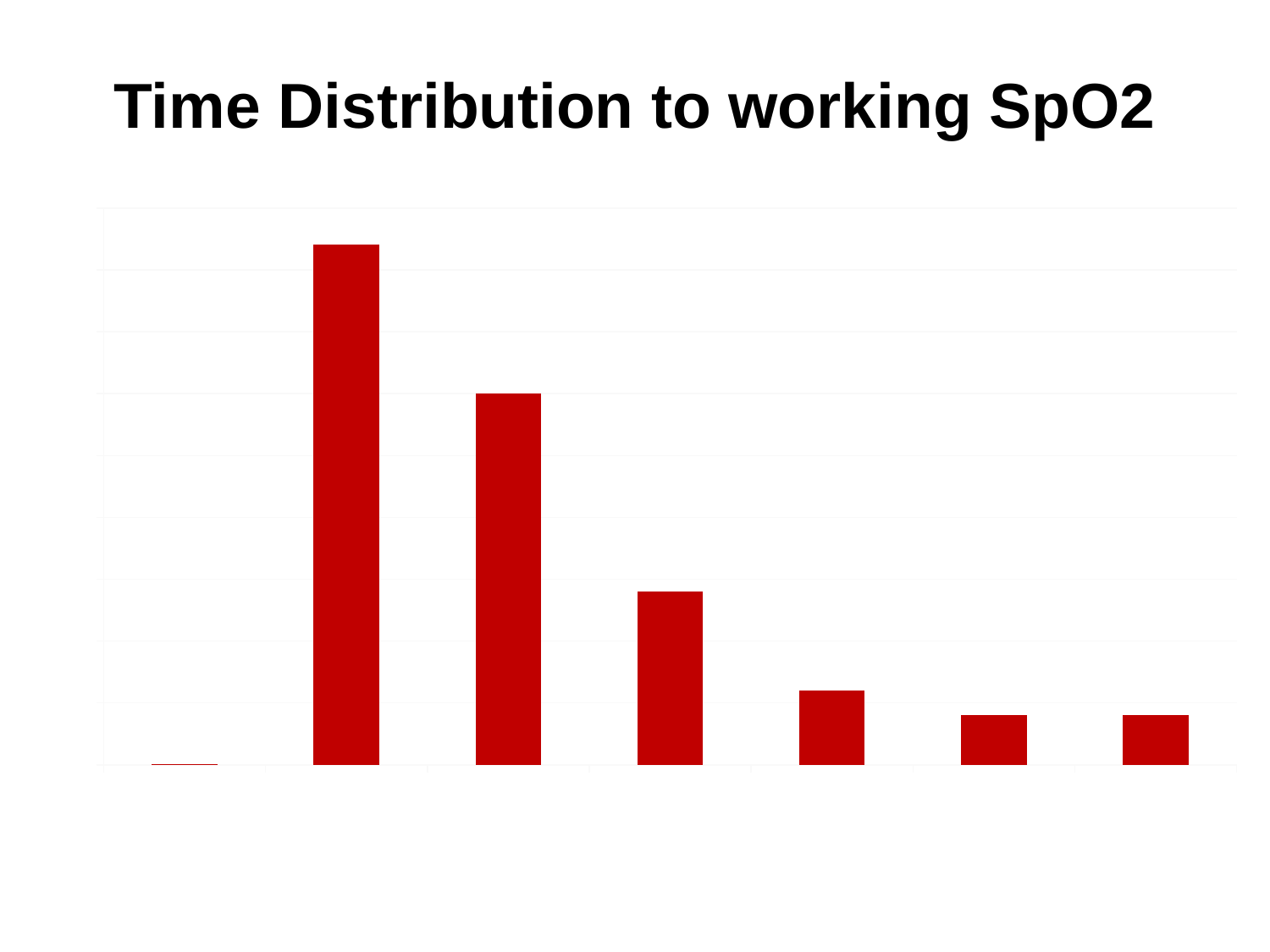
What kind of chart is shown on the slide? bar chart What colour are the bars in the chart? red What is the title of the chart on the slide? Time Distribution to working SpO2 Which is taller, the second bar from the left or the third bar from the left? the second bar from the left Which bar in the chart is the tallest? the second bar from the left From the second bar onward, do the bar heights generally rise or fall moving left to right? fall Which is taller, the third bar from the left or the fourth bar from the left? the third bar from the left Which is taller, the fourth bar from the left or the fifth bar from the left? the fourth bar from the left